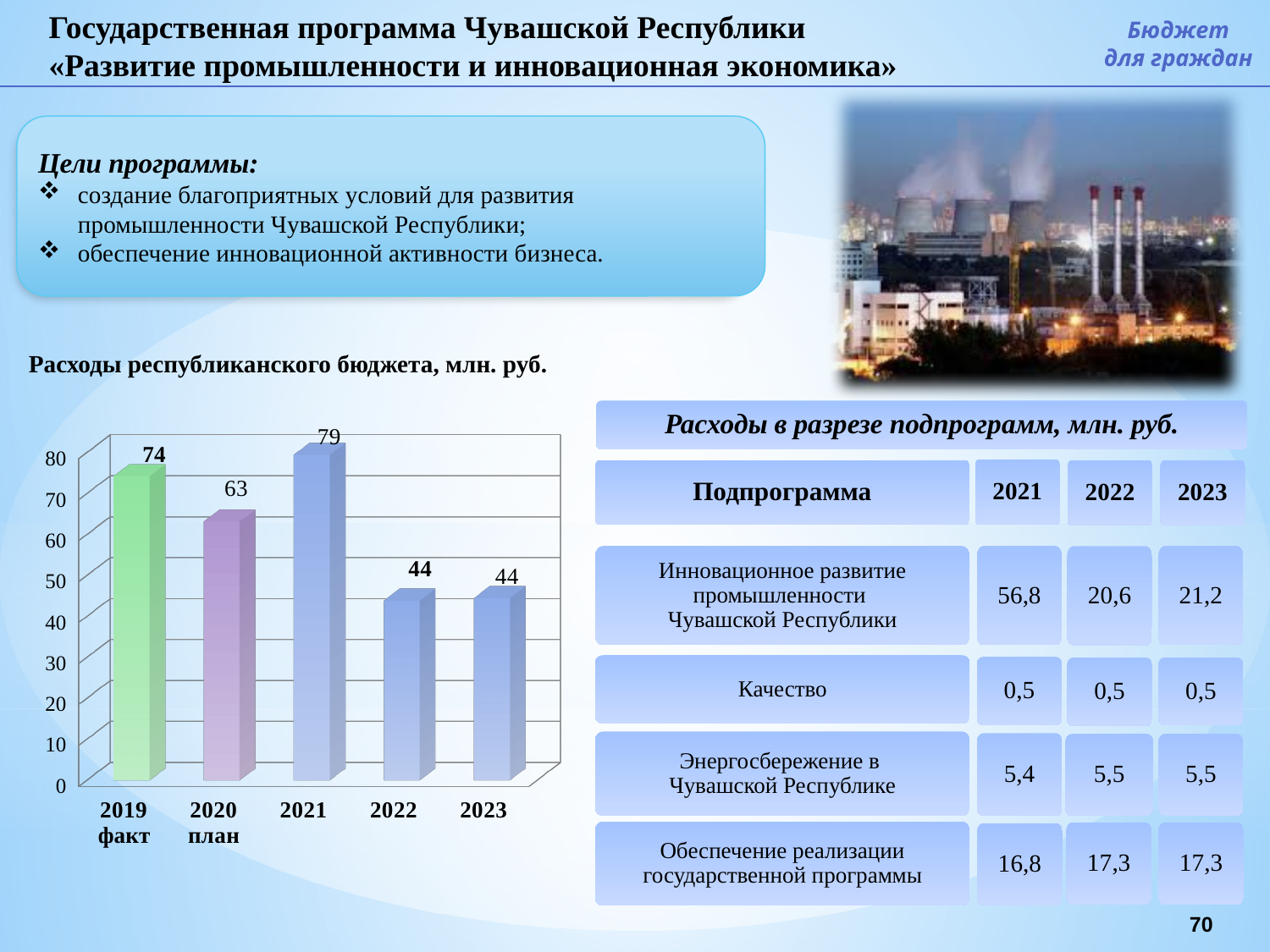
Which is larger, the value for 2019 факт or the value for 2020 план? 2019 факт What kind of chart is shown on the slide? bar chart Do the values rise or fall from 2021 to 2022 in the chart? fall What is the difference between the values for 2021 and 2020 план? 16 What is the value for 2019 факт in the chart "Расходы республиканского бюджета, млн. руб."? 74 Which category has the highest value in the chart? 2021 How many categories are shown on the x axis of the chart? 5 What is the value for 2023 in the chart? 44 What is the value for 2021 in the chart? 79 What is the title of the chart on the slide? Расходы республиканского бюджета, млн. руб. What is the difference between the values for 2019 факт and 2022? 30 What is the value for 2020 план in the chart? 63